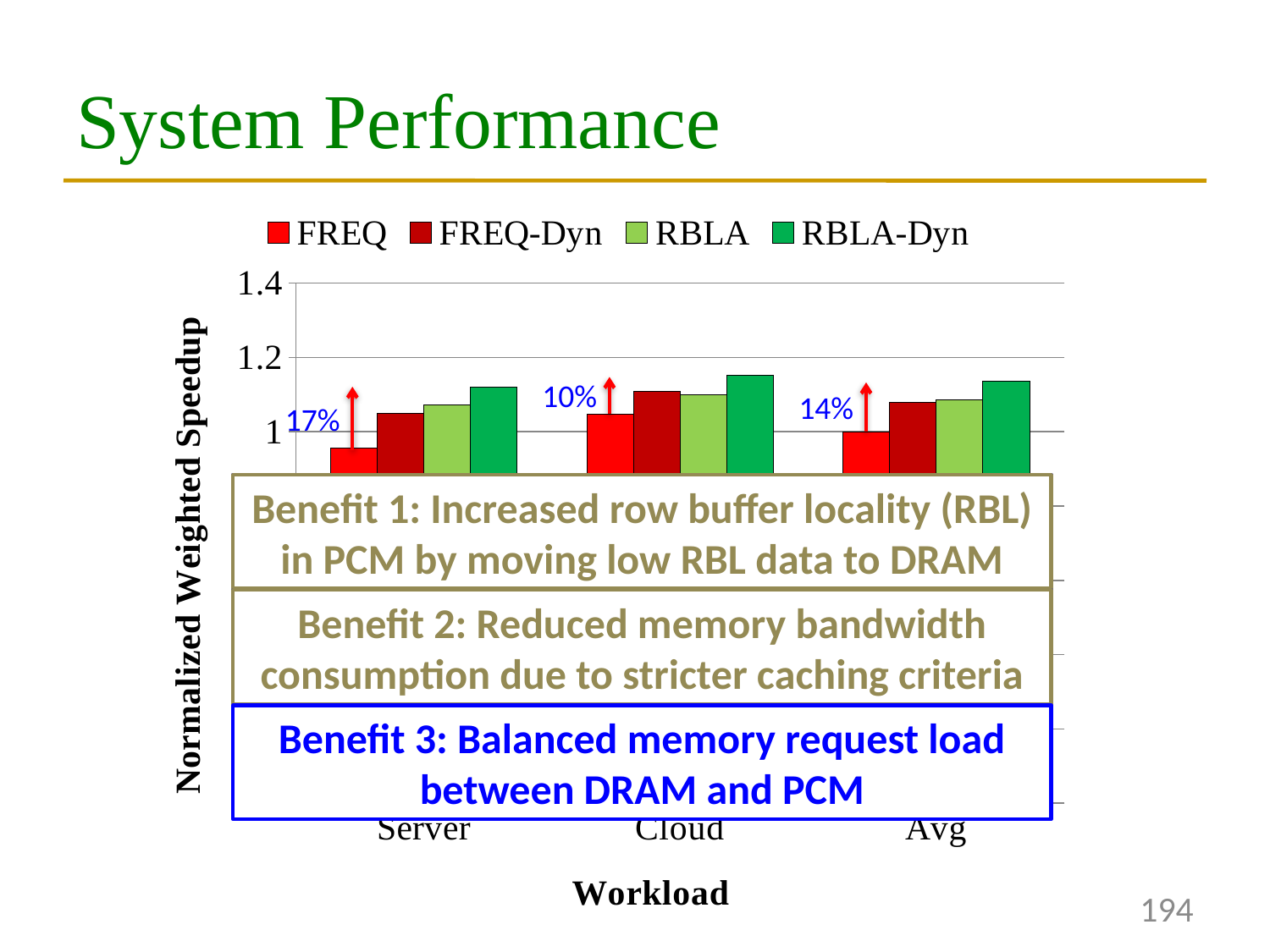
Is the RBLA-Dyn value for Server greater or less than 1? greater What kind of chart is shown on the slide? bar chart Which series has the lowest bar for the Server workload? FREQ Is the FREQ value for Server greater or less than 1? less Which series has the highest bar for the Cloud workload? RBLA-Dyn What is the title of the y axis? Normalized Weighted Speedup Is the RBLA-Dyn value for Cloud greater or less than 1.2? less How many series does the legend list? 4 Which series has the lowest bar for the Avg workload? FREQ How many workload categories are shown on the x axis? 3 Which series has the highest bar for the Server workload? RBLA-Dyn What percentage improvement is annotated above the Server group of bars? 17%